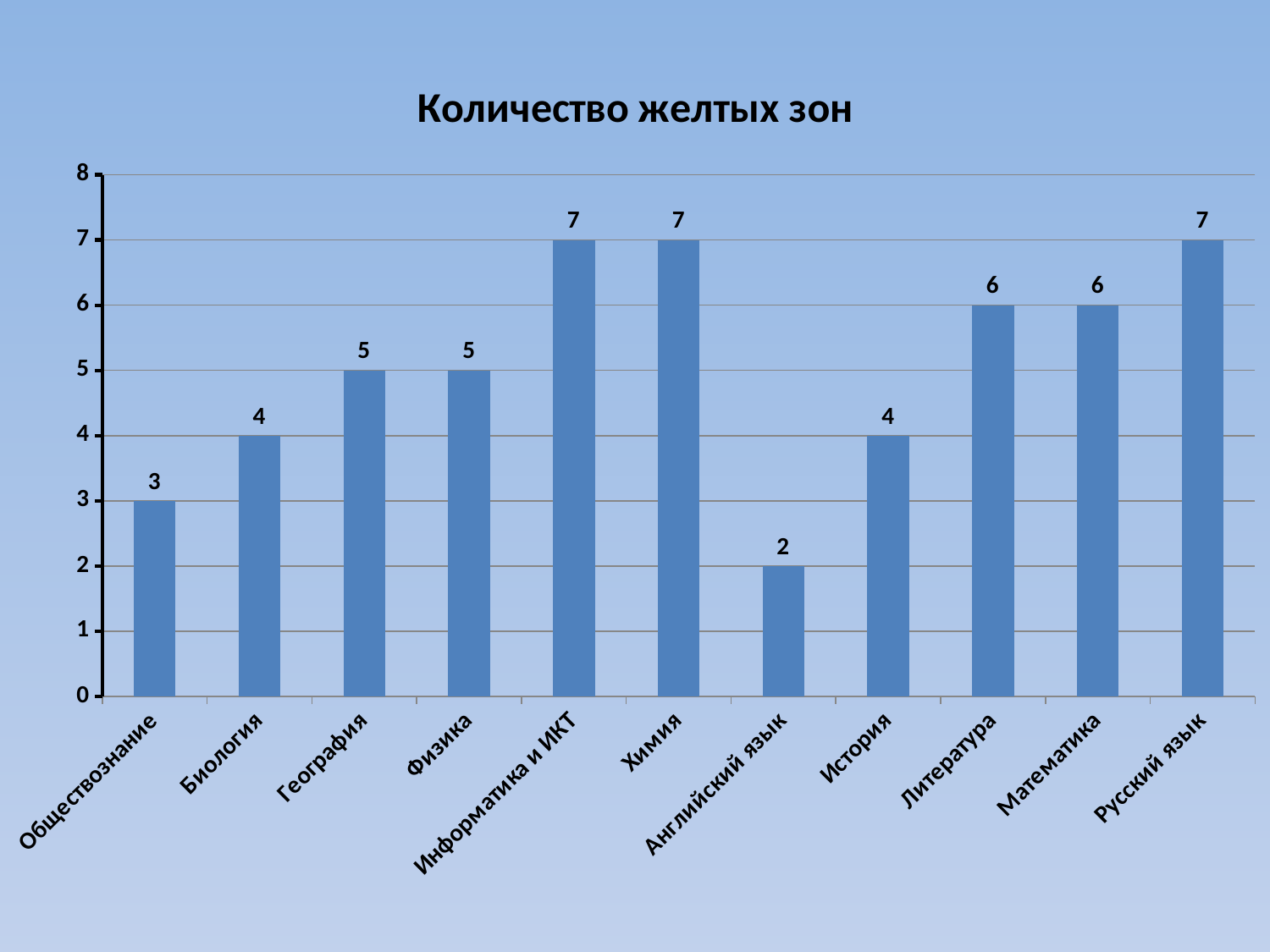
How many categories are shown on the x axis? 11 What is the value for Биология? 4 Which category has the lowest value? Английский язык What is the value for Русский язык? 7 What is the title of the chart? Количество желтых зон What is the value for Английский язык? 2 What is the difference between the values for Химия and Обществознание? 4 What kind of chart is this? bar chart Is the value for Математика greater or less than 5? greater What is the value for Литература? 6 What is the difference between the values for Информатика и ИКТ and Английский язык? 5 Which is larger, the value for География or the value for История? География